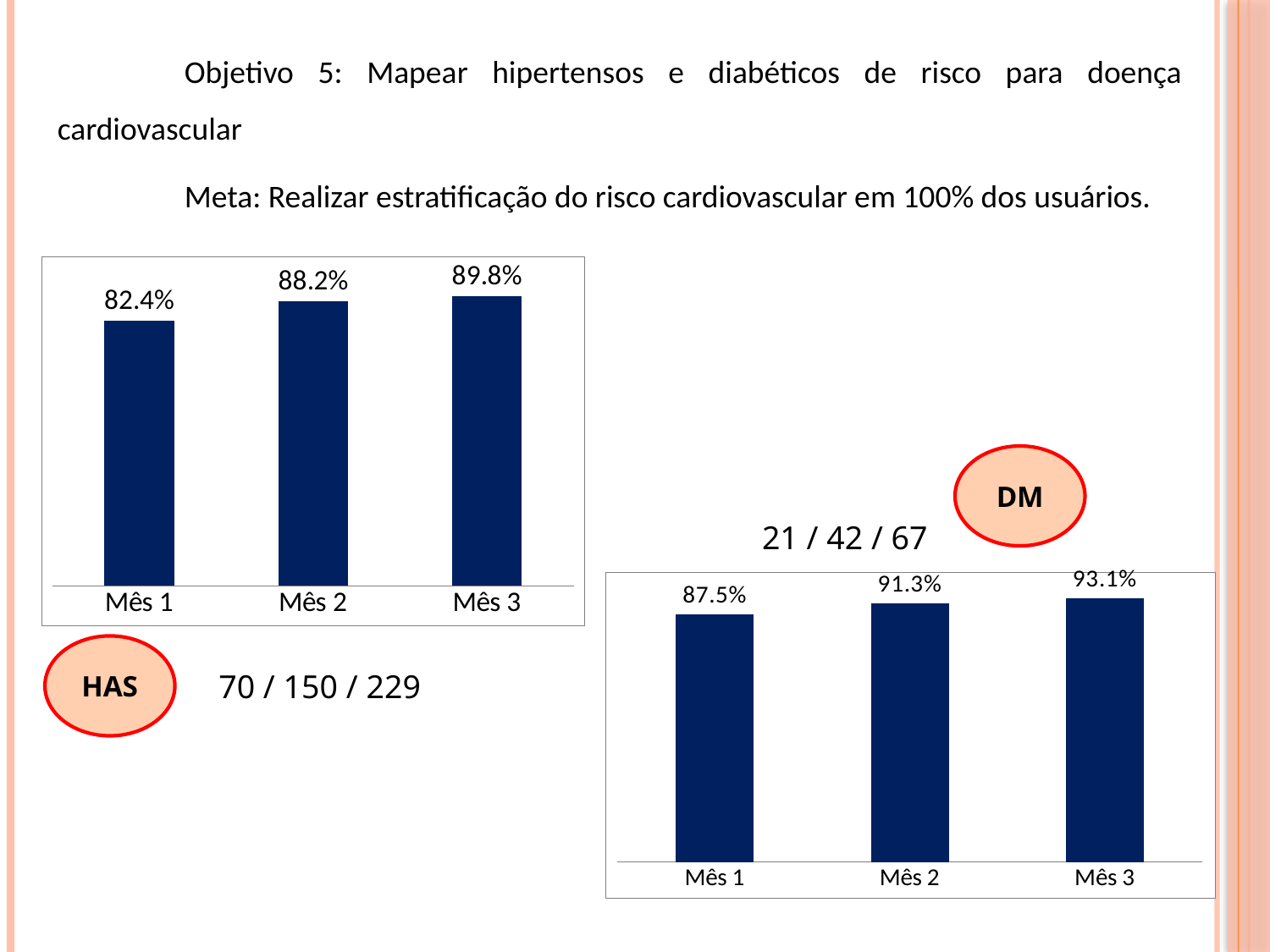
In the left chart (HAS), what is the difference between the values for Mês 3 and Mês 1? 7.4 percentage points In the left chart (HAS), what is the value for Mês 3? 89.8% In the right chart (DM), what is the difference between the values for Mês 2 and Mês 1? 3.8 percentage points In the right chart (DM), which month has the highest value? Mês 3 What kind of chart is the left chart (HAS)? Bar chart In the right chart (DM), what is the value for Mês 3? 93.1% How many bars are in the right chart (DM)? 3 In the left chart (HAS), which is larger, the value for Mês 2 or Mês 1? Mês 2 In the right chart (DM), what is the value for Mês 2? 91.3% In the left chart (HAS), which month has the lowest value? Mês 1 In the left chart (HAS), what is the value for Mês 1? 82.4% In the right chart (DM), do the values rise or fall from Mês 1 to Mês 3? Rise